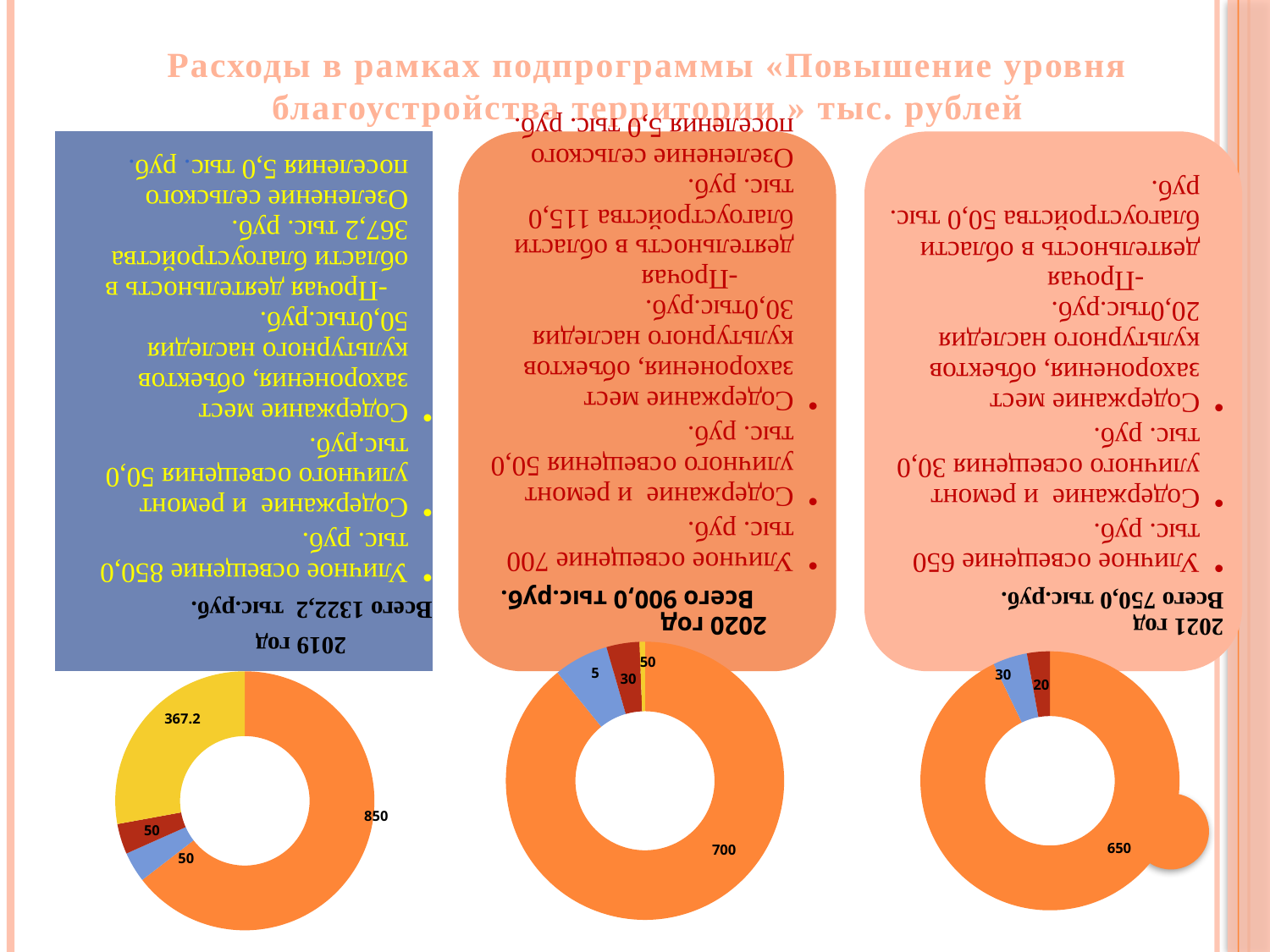
How many labeled slices does the left chart have? 4 In the middle chart, what is the difference between the slice labeled 700 and the slice labeled 50? 650 In the right chart, what is the value of the largest slice? 650 In the left chart, what is the value of the yellow slice? 367.2 What kind of chart is the left chart on the slide? doughnut chart In the right chart, what is the difference between the slices labeled 30 and 20? 10 In the left chart, what is the difference between the largest slice (850) and the yellow slice (367.2)? 482.8 In the middle chart, what is the value of the largest slice? 700 In the middle chart, which is larger: the slice labeled 30 or the slice labeled 50? 50 In the middle chart, what is the value of the smallest labeled slice? 5 How many charts are shown on the slide? 3 In the left chart, what is the value of the largest slice? 850